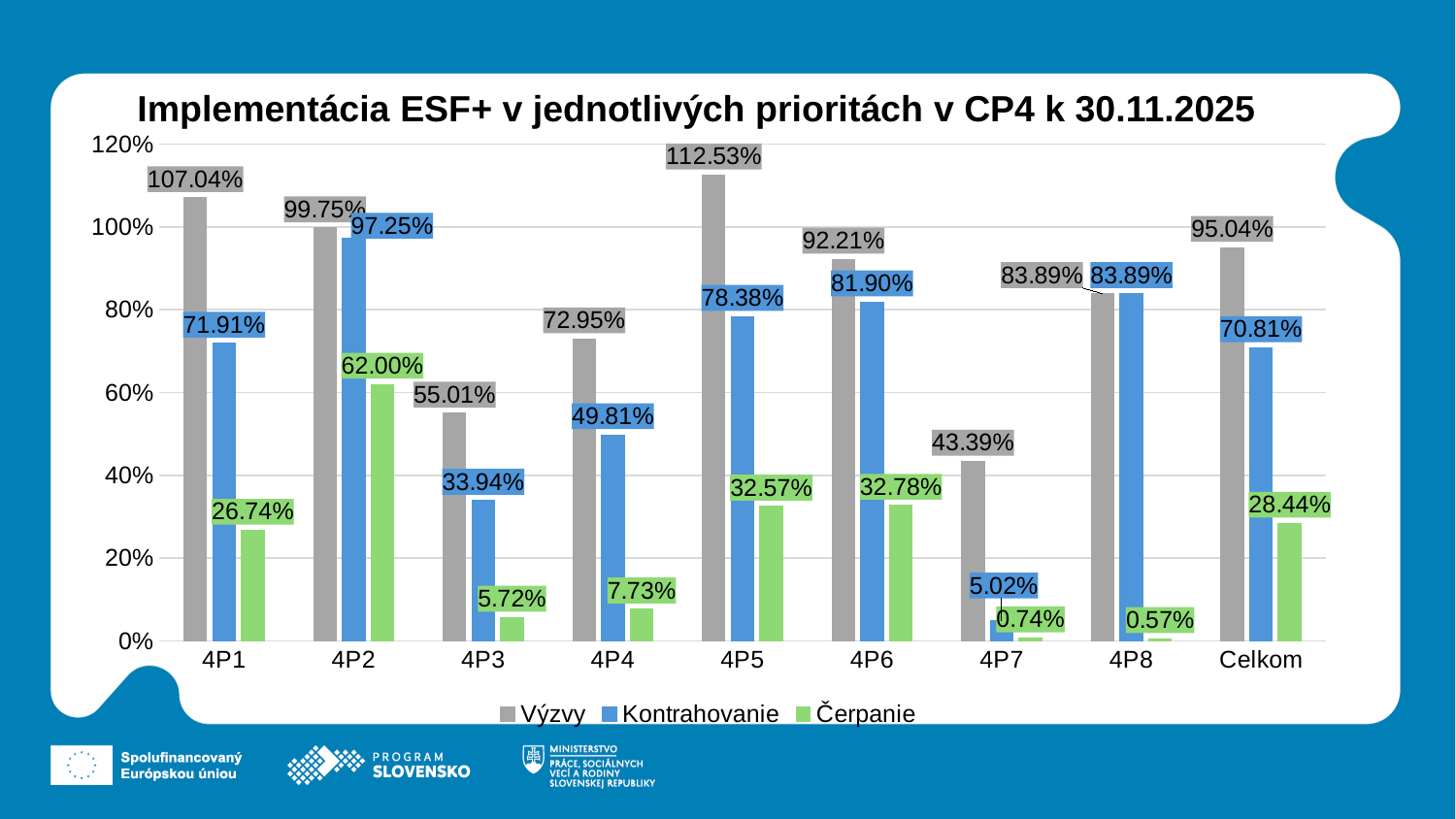
Which category has the lowest Čerpanie value? 4P8 What is the Čerpanie value for 4P2? 62.00% How many categories are shown on the x axis? 9 What is the difference between the Výzvy and Kontrahovanie values for 4P1? 35.13 percentage points What are the three series named in the legend? Výzvy, Kontrahovanie, Čerpanie Which has the larger Kontrahovanie value, 4P2 or 4P6? 4P2 Is the Čerpanie value for 4P3 greater or less than 20%? less What kind of chart is shown on the slide? bar chart Which category has the highest Výzvy value? 4P5 What is the Kontrahovanie value for Celkom? 70.81% What is the Výzvy value for 4P5? 112.53% How many series does the legend list? 3